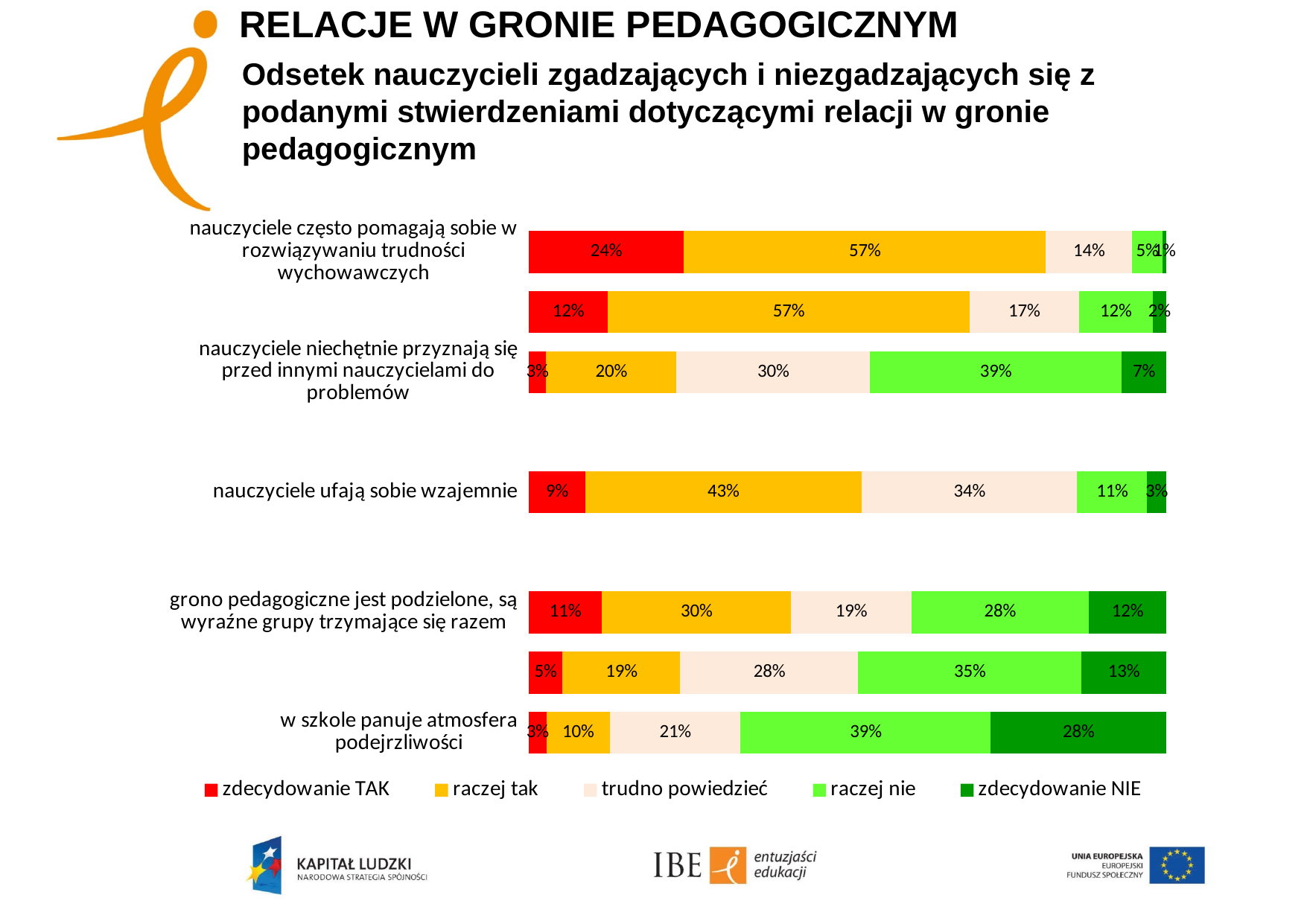
What is the "zdecydowanie NIE" value for "w szkole panuje atmosfera podejrzliwości"? 28% What percentage of teachers answered "zdecydowanie TAK" to "nauczyciele często pomagają sobie w rozwiązywaniu trudności wychowawczych"? 24% What is the difference between the "raczej tak" values for "nauczyciele często pomagają sobie w rozwiązywaniu trudności wychowawczych" and "nauczyciele ufają sobie wzajemnie"? 14 percentage points Which legend entry is shown in red? zdecydowanie TAK What is the "raczej nie" value for "nauczyciele niechętnie przyznają się przed innymi nauczycielami do problemów"? 39% What percentage of teachers answered "raczej tak" to "nauczyciele ufają sobie wzajemnie"? 43% What kind of chart is shown on the slide? Stacked bar chart Which is larger: the "raczej nie" value for "nauczyciele ufają sobie wzajemnie" or for "grono pedagogiczne jest podzielone, są wyraźne grupy trzymające się razem"? grono pedagogiczne jest podzielone, są wyraźne grupy trzymające się razem How many series does the legend list? 5 What is the "trudno powiedzieć" value for "grono pedagogiczne jest podzielone, są wyraźne grupy trzymające się razem"? 19% Which statement has the highest "zdecydowanie NIE" share? w szkole panuje atmosfera podejrzliwości Which statement has the lowest "zdecydowanie TAK" share among the labelled statements? It is a tie at 3%: "nauczyciele niechętnie przyznają się przed innymi nauczycielami do problemów" and "w szkole panuje atmosfera podejrzliwości"